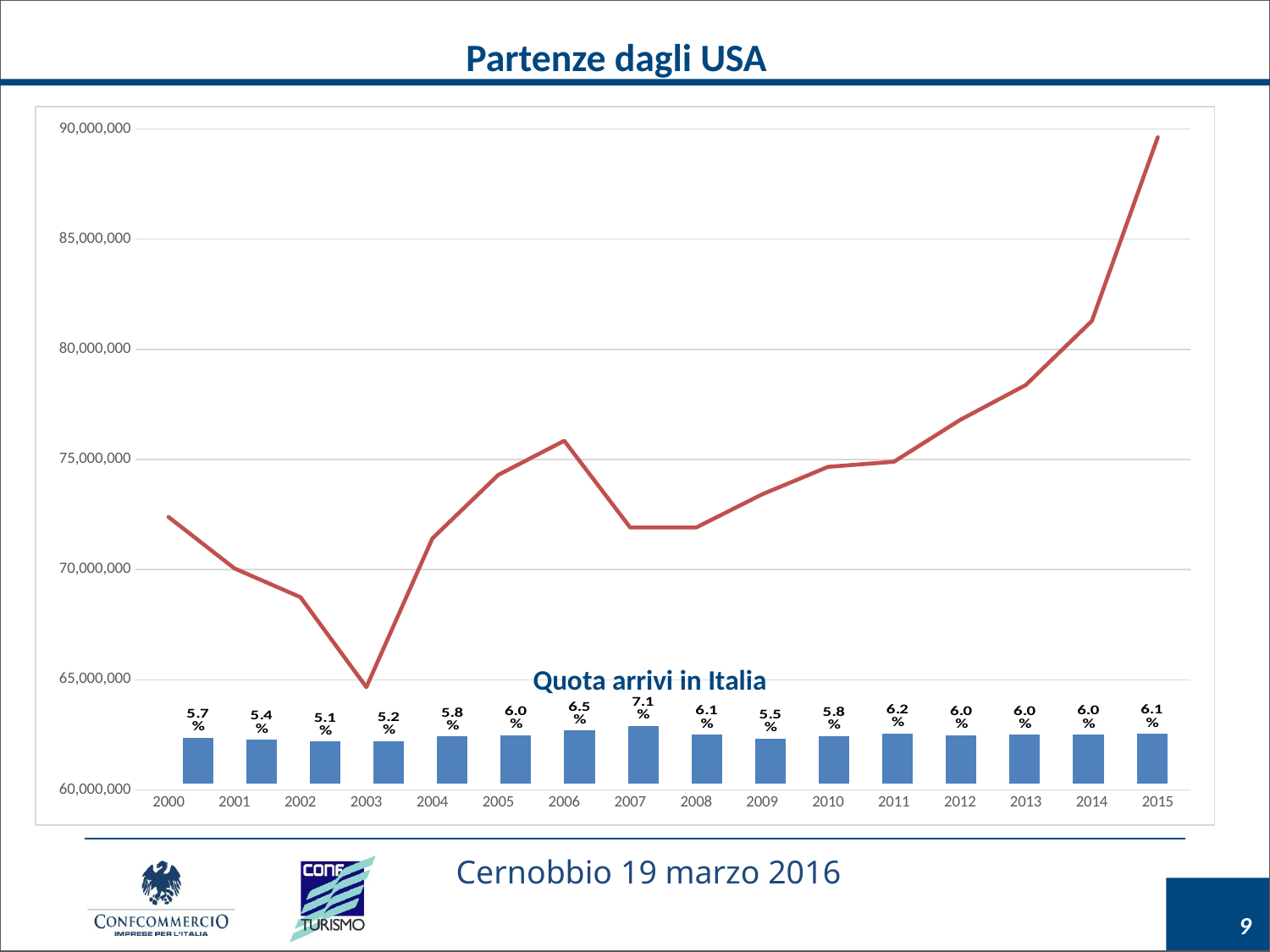
Is the value of the Partenze dagli USA line for 2003 greater or less than 65,000,000? less Is the value of the Partenze dagli USA line for 2015 greater or less than 85,000,000? greater What is the Quota arrivi in Italia value for 2000? 5.7% Which year has the highest Quota arrivi in Italia? 2007 Which year has a larger Quota arrivi in Italia, 2006 or 2009? 2006 What is the Quota arrivi in Italia value for 2007? 7.1% Does the Partenze dagli USA line rise or fall from 2008 to 2015? rise What is the difference between the Quota arrivi in Italia for 2007 and 2002? 2.0% What is the Quota arrivi in Italia value for 2015? 6.1% Which year has the lowest Quota arrivi in Italia? 2002 How many years are shown on the x axis of the chart? 16